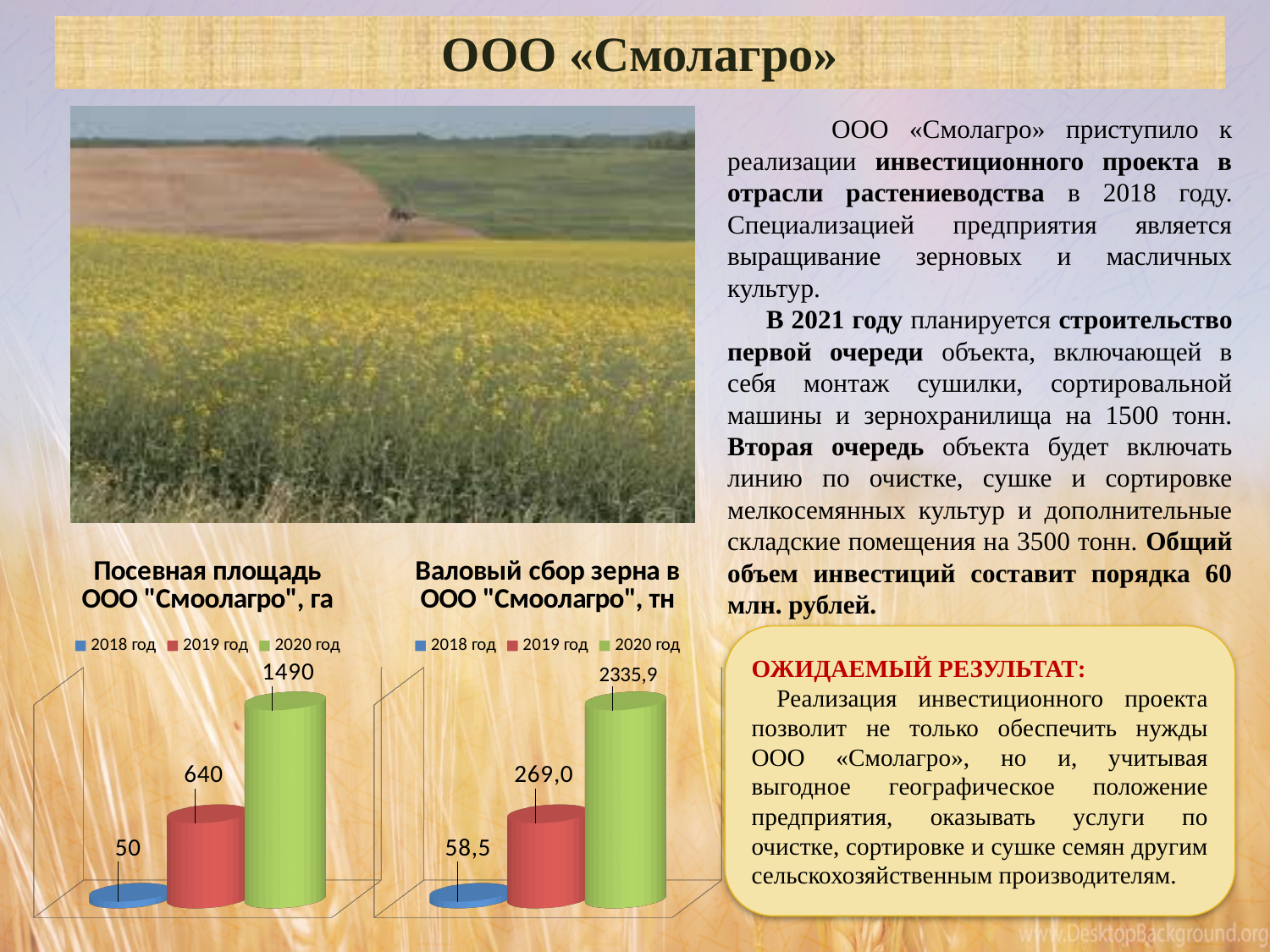
How many series does the legend list in the chart titled "Посевная площадь ООО "Смоолагро", га"? 3 In the chart titled "Посевная площадь ООО "Смоолагро", га", do the values rise or fall from 2018 год to 2020 год? rise In the chart titled "Посевная площадь ООО "Смоолагро", га", what is the value for 2018 год? 50 In the chart titled "Посевная площадь ООО "Смоолагро", га", which year has the highest value? 2020 год In the chart titled "Посевная площадь ООО "Смоолагро", га", what is the difference between the values for 2020 год and 2019 год? 850 In the chart titled "Посевная площадь ООО "Смоолагро", га", what is the value for 2020 год? 1490 In the chart titled "Валовый сбор зерна в ООО "Смоолагро", тн", what is the difference between the values for 2019 год and 2018 год? 210,5 In the chart titled "Валовый сбор зерна в ООО "Смоолагро", тн", which year has the lowest value? 2018 год In the chart titled "Валовый сбор зерна в ООО "Смоолагро", тн", which is larger, the value for 2019 год or 2020 год? 2020 год In the chart titled "Валовый сбор зерна в ООО "Смоолагро", тн", what is the value for 2020 год? 2335,9 In the chart titled "Валовый сбор зерна в ООО "Смоолагро", тн", what is the value for 2019 год? 269,0 What kind of chart is the chart titled "Валовый сбор зерна в ООО "Смоолагро", тн"? bar chart